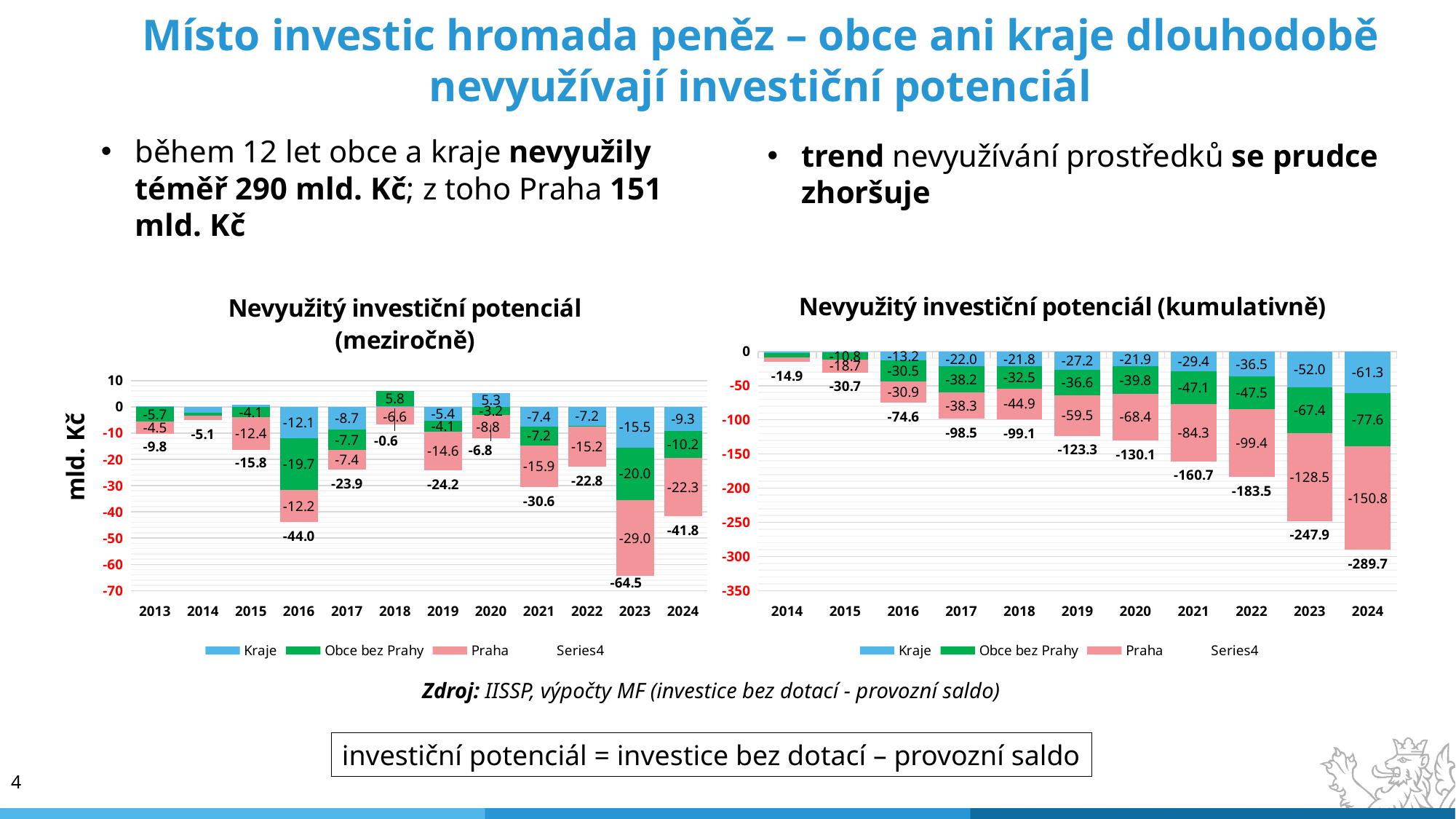
In the right chart 'Nevyužitý investiční potenciál (kumulativně)', which year has the most negative total? 2024 In the right chart 'Nevyužitý investiční potenciál (kumulativně)', what is the value for Kraje in 2023? -52.0 In the left chart 'Nevyužitý investiční potenciál (meziročně)', what is the value for Obce bez Prahy in 2018? 5.8 In the left chart 'Nevyužitý investiční potenciál (meziročně)', what is the total value labelled for 2023? -64.5 In the right chart 'Nevyužitý investiční potenciál (kumulativně)', do the totals rise or fall from 2014 to 2024? fall What kind of chart is the left chart 'Nevyužitý investiční potenciál (meziročně)'? stacked bar chart In the right chart 'Nevyužitý investiční potenciál (kumulativně)', what is the difference between the Praha values for 2024 and 2023? 22.3 In the left chart 'Nevyužitý investiční potenciál (meziročně)', which year has the total closest to zero? 2018 In the left chart 'Nevyužitý investiční potenciál (meziročně)', how many years are shown on the x axis? 12 How many entries does the legend of the right chart 'Nevyužitý investiční potenciál (kumulativně)' list? 4 In the left chart 'Nevyužitý investiční potenciál (meziročně)', what is the value for Praha in 2024? -22.3 In the right chart 'Nevyužitý investiční potenciál (kumulativně)', what is the total value labelled for 2024? -289.7